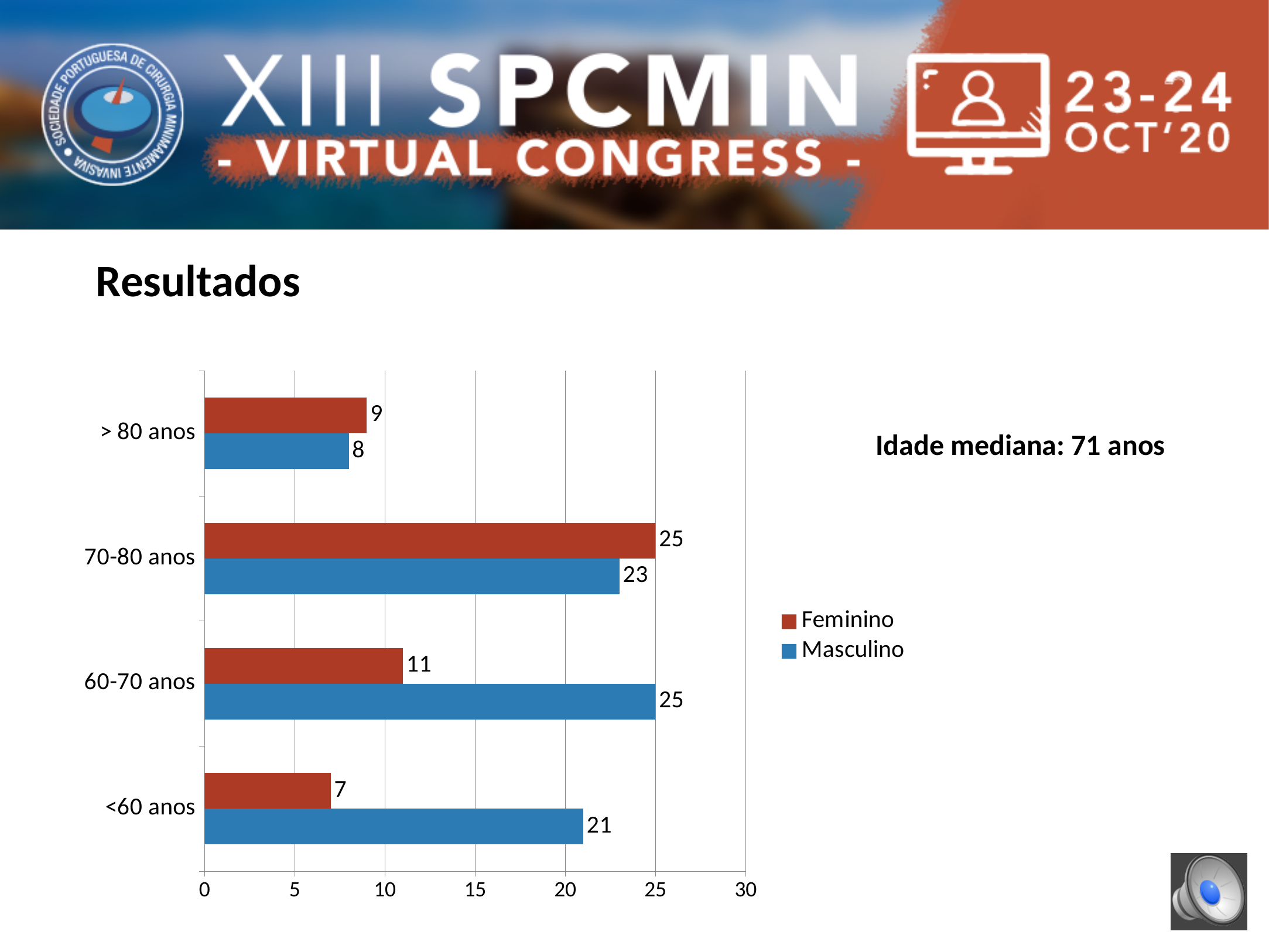
What is the Masculino value for the <60 anos category? 21 What is the Masculino value for the > 80 anos category? 8 Which colour represents the Masculino series in the legend? Blue What is the total of the Feminino and Masculino values for the > 80 anos category? 17 How many series does the legend list? 2 Which age category has the highest Masculino value? 60-70 anos What kind of chart is shown on the slide? Bar chart How many age categories are shown on the chart? 4 Which age category has the lowest Feminino value? <60 anos What is the Feminino value for the 70-80 anos category? 25 What is the difference between the Masculino and Feminino values for the 60-70 anos category? 14 Which is larger for the 70-80 anos category, Feminino or Masculino? Feminino